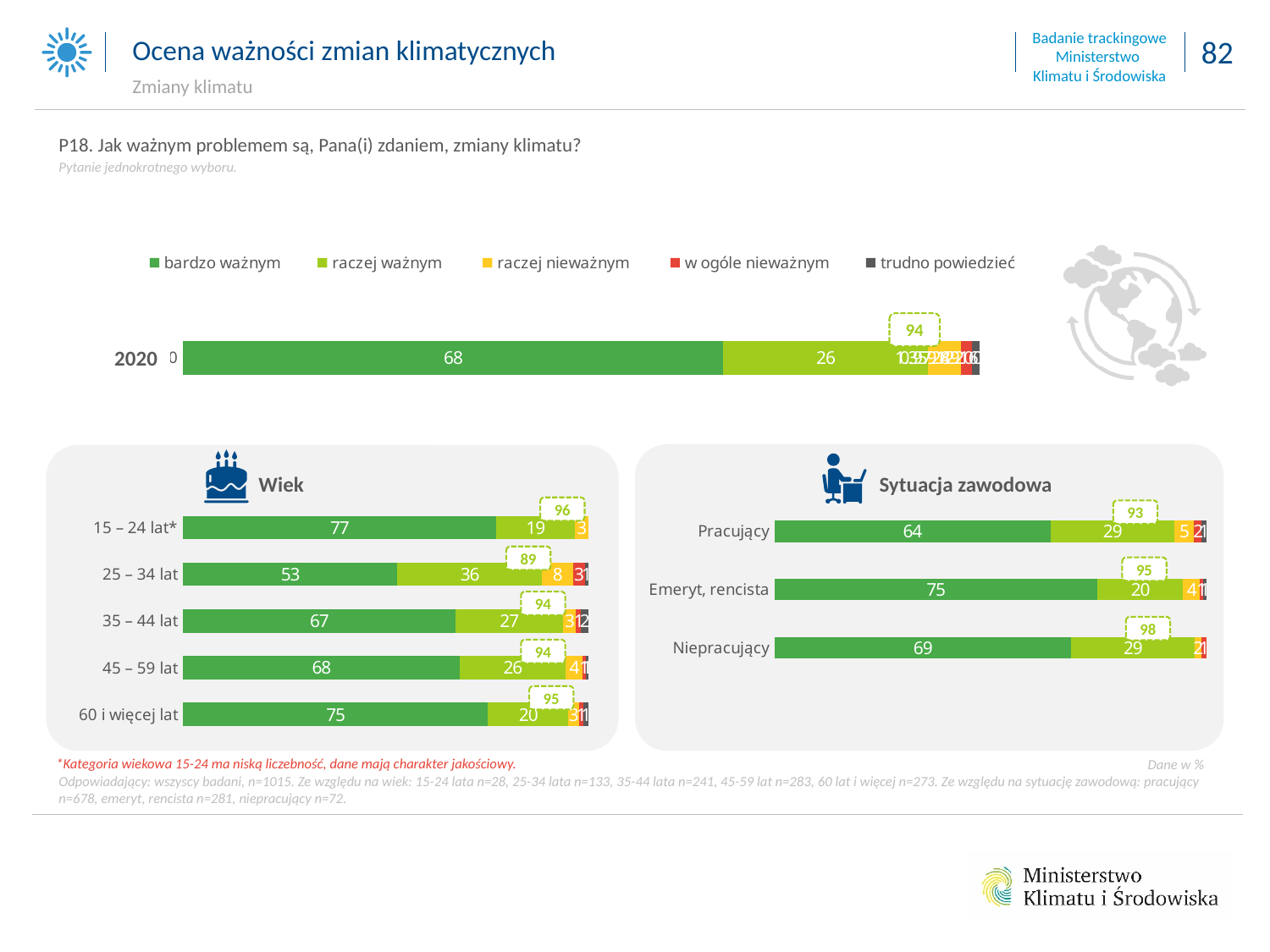
In the 'Wiek' chart, which age group has the lowest value for 'bardzo ważnym'? 25 – 34 lat In the 'Wiek' chart, which age group has the highest value for 'bardzo ważnym'? 15 – 24 lat* In the 'Wiek' chart, what is the value for 'raczej ważnym' for the 60 i więcej lat group? 20 In the 'Sytuacja zawodowa' chart, which group has the lowest value for 'bardzo ważnym'? Pracujący How many age groups are shown in the 'Wiek' chart? 5 How many series does the legend list? 5 In the 'Wiek' chart, what is the difference between the 'bardzo ważnym' values for 15 – 24 lat* and 25 – 34 lat? 24 In the top '2020' chart, what is the value for 'bardzo ważnym'? 68 In the 'Sytuacja zawodowa' chart, what is the value for 'raczej ważnym' for 'Pracujący'? 29 In the 'Wiek' chart, what is the value for 'bardzo ważnym' for the 25 – 34 lat group? 53 In the 'Sytuacja zawodowa' chart, what is the value for 'bardzo ważnym' for 'Emeryt, rencista'? 75 In the 'Sytuacja zawodowa' chart, which is larger: the 'bardzo ważnym' value for 'Niepracujący' or for 'Pracujący'? Niepracujący